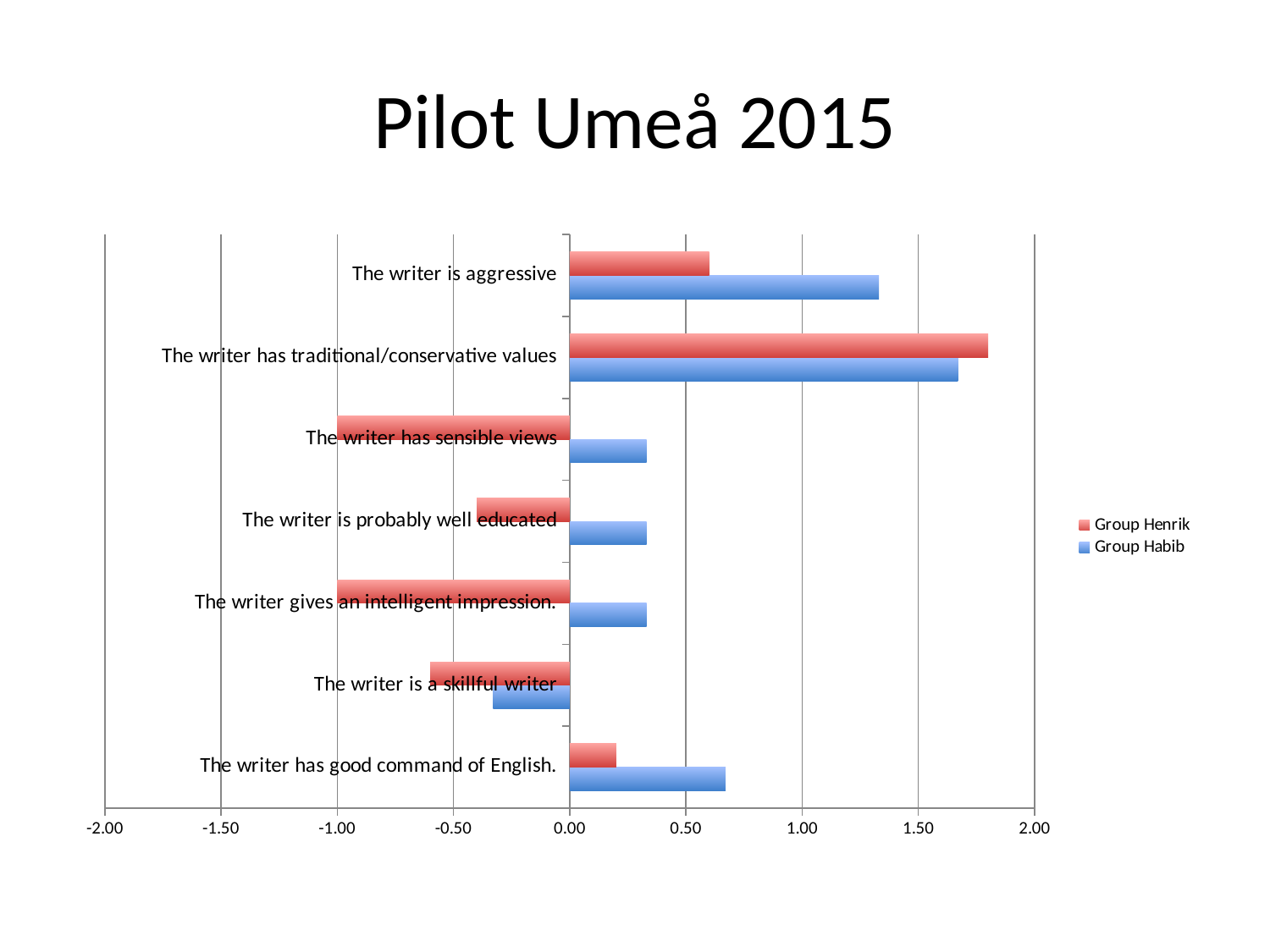
Is the Group Henrik value for 'The writer has traditional/conservative values' greater or less than 1.50? greater For which category is the Group Henrik value highest? The writer has traditional/conservative values How many categories are plotted on the chart? 7 Is the Group Habib value for 'The writer is aggressive' greater or less than 1.00? greater For 'The writer is aggressive', which group has the larger value, Group Henrik or Group Habib? Group Habib Which colour represents Group Habib in the chart? blue What kind of chart is shown on the slide? bar chart What is the title of the slide? Pilot Umeå 2015 For which category is the Group Habib value lowest? The writer is a skillful writer How many series does the legend list? 2 For 'The writer has good command of English.', which group has the larger value, Group Henrik or Group Habib? Group Habib Is the Group Henrik value for 'The writer is a skillful writer' greater or less than -0.50? less